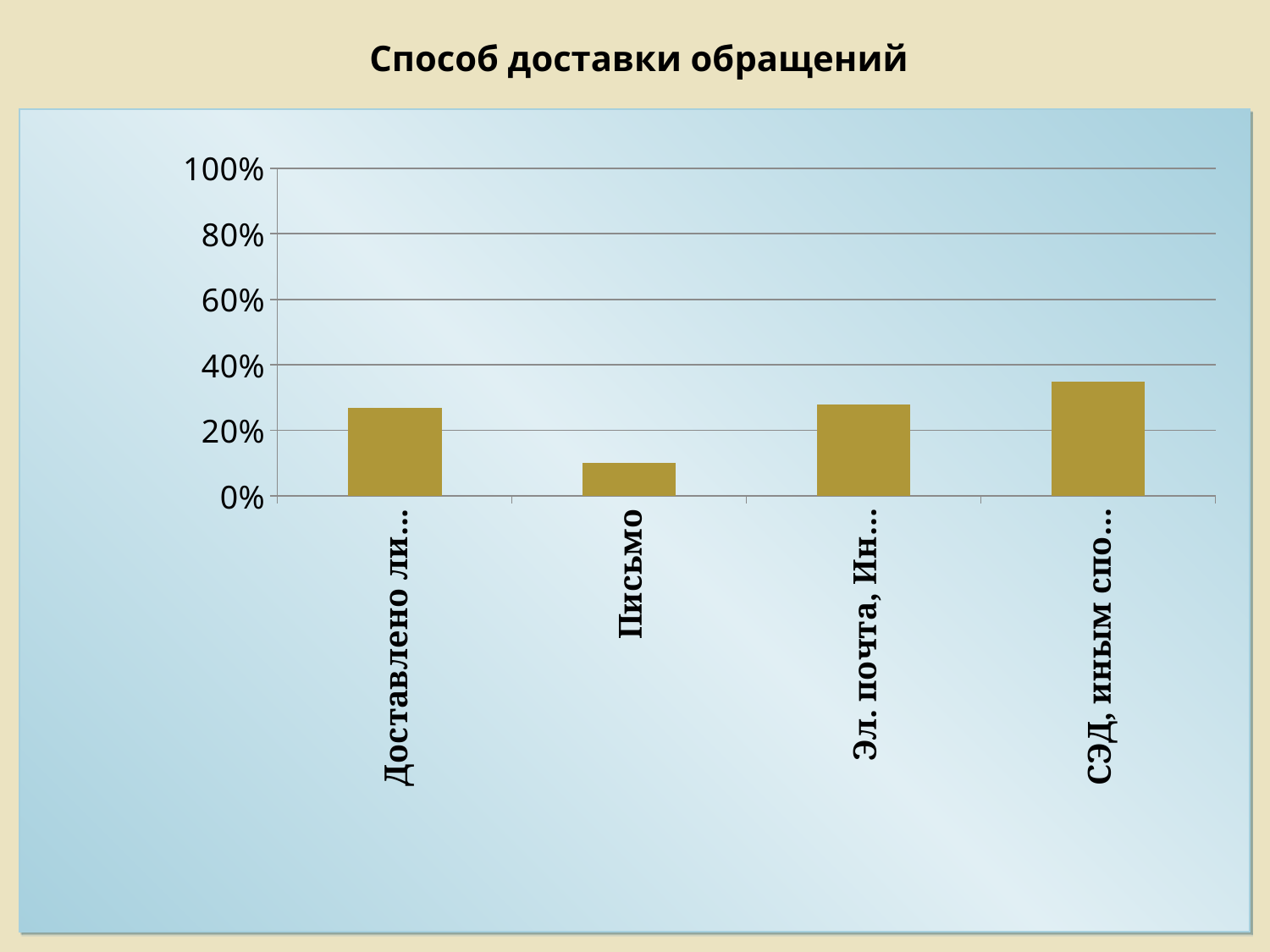
Which category has the lowest bar? Письмо What kind of chart is shown on the slide? bar chart Which bar is the highest: the one labelled "Письмо" or the fourth bar labelled "СЭД, иным спо..."? СЭД, иным спо... Is the value for the third bar ("Эл. почта, Ин...") greater or less than 40%? less Is the value for the fourth bar ("СЭД, иным спо...") greater or less than 20%? greater Is the value for "Письмо" greater or less than 20%? less What is the highest value shown on the vertical axis? 100% Which category has the highest bar? СЭД, иным спо... How many categories (bars) does the chart show? 4 What is the title of the chart? Способ доставки обращений